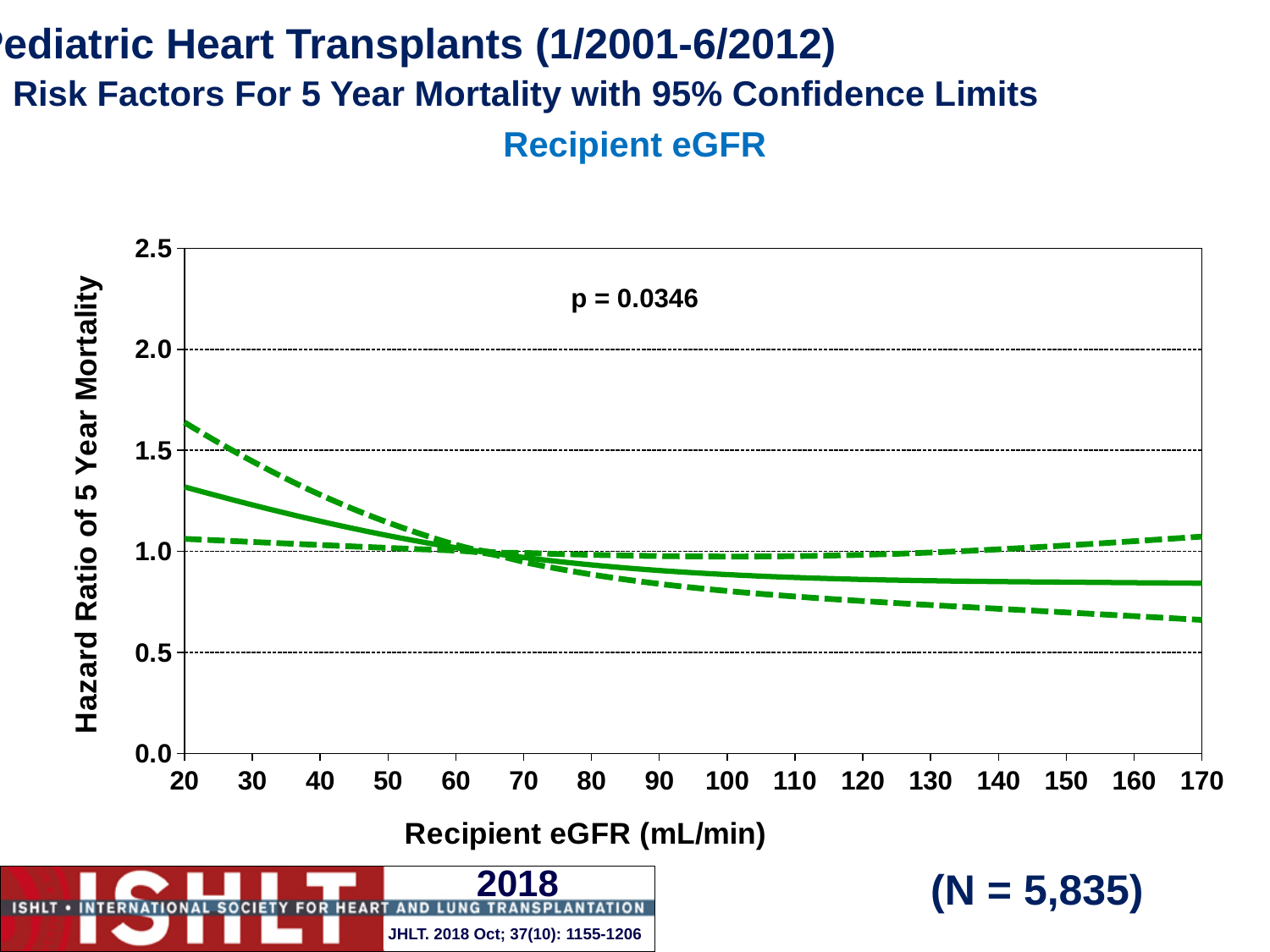
Is the upper dashed confidence limit at a recipient eGFR of 20 mL/min greater or less than 1.5? greater What kind of chart is shown on the slide? line chart How many tick labels are shown on the x axis? 16 Is the hazard ratio on the solid line at a recipient eGFR of 170 mL/min greater or less than 1.0? less What p-value is printed on the chart? p = 0.0346 Is the solid hazard ratio line at a recipient eGFR of 170 mL/min greater or less than 0.5? greater What sample size (N) is shown on the slide? N = 5,835 Does the solid hazard ratio line rise or fall as recipient eGFR increases from 20 to 170 mL/min? fall How many lines are plotted on the chart? 3